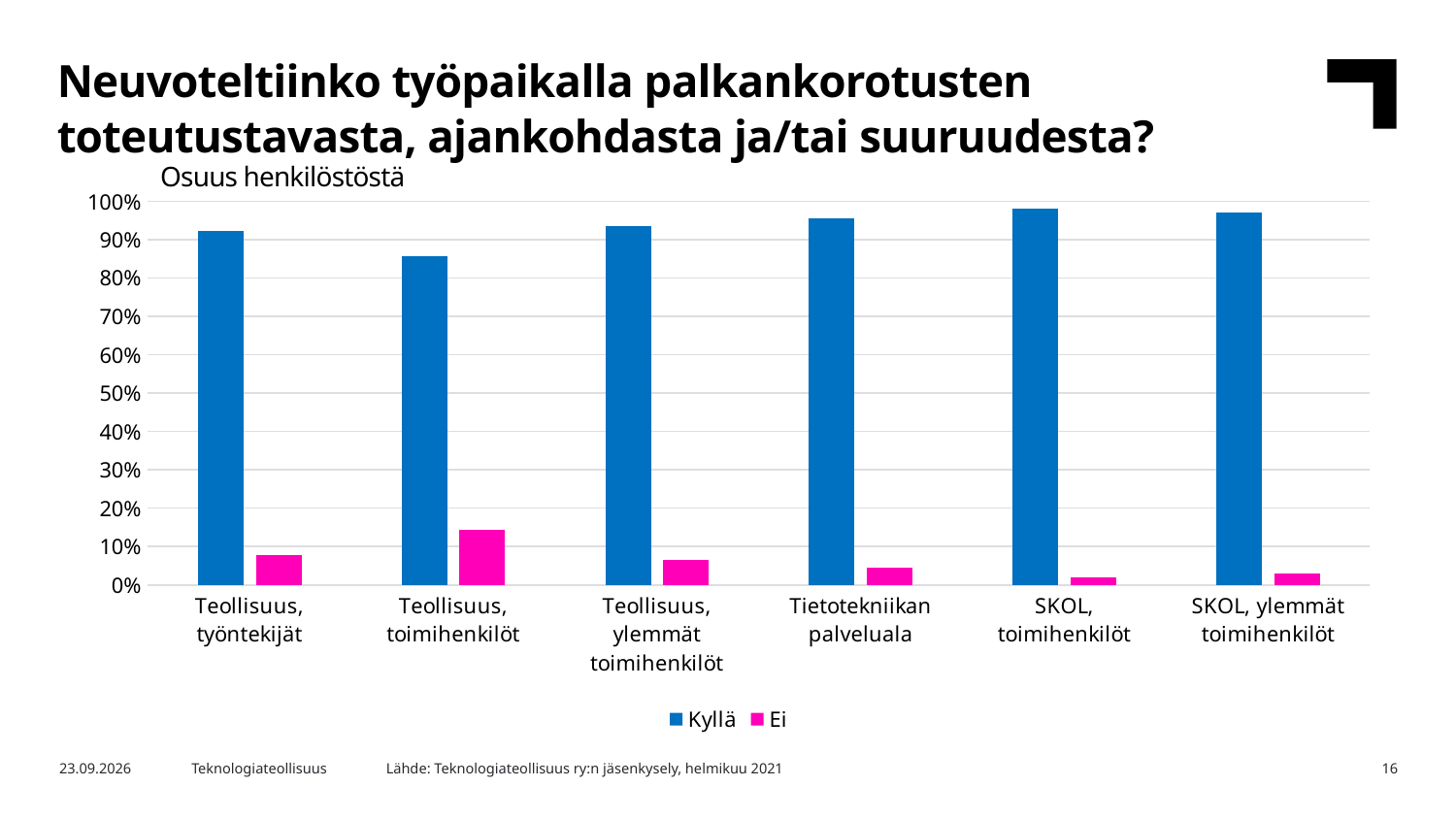
Which category has the highest Ei value? Teollisuus, toimihenkilöt Which category has the lowest Kyllä value? Teollisuus, toimihenkilöt Which has the larger Kyllä value: Teollisuus, työntekijät or Teollisuus, toimihenkilöt? Teollisuus, työntekijät Is the Ei value for Teollisuus, toimihenkilöt greater or less than 10%? greater Is the Kyllä value for Teollisuus, toimihenkilöt greater or less than 90%? less What are the two series named in the chart's legend? Kyllä and Ei How many series does the chart's legend list? 2 How many categories are shown on the x axis of the chart? 6 What kind of chart is shown on the slide? Bar chart What label is shown above the vertical axis of the chart? Osuus henkilöstöstä Is the Kyllä value for Tietotekniikan palveluala greater or less than 90%? greater